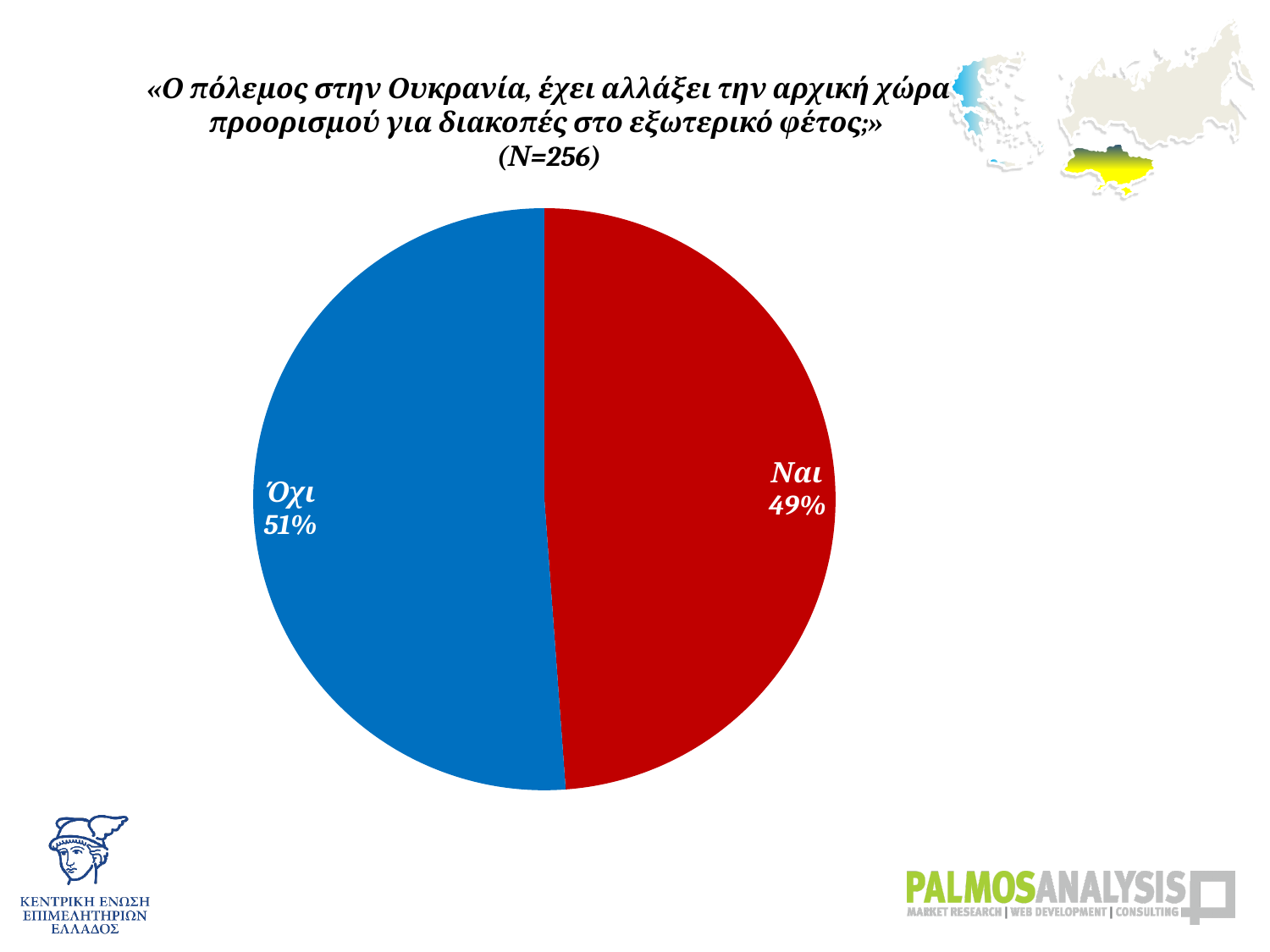
What is the combined share of the Όχι and Ναι slices? 100% What percentage of respondents answered Ναι? 49% How many slices does the pie chart have? 2 What is the sample size (N) stated in the chart title? 256 What is the difference in percentage points between the Όχι and Ναι slices? 2 percentage points What colour is the Ναι slice of the pie? Red Which response has the largest share of the pie? Όχι Which response has the smallest share of the pie? Ναι What percentage of respondents answered Όχι? 51% Which response has the larger share of the pie, Όχι or Ναι? Όχι What kind of chart is shown on the slide? Pie chart Is the share for Ναι greater or less than 50%? less